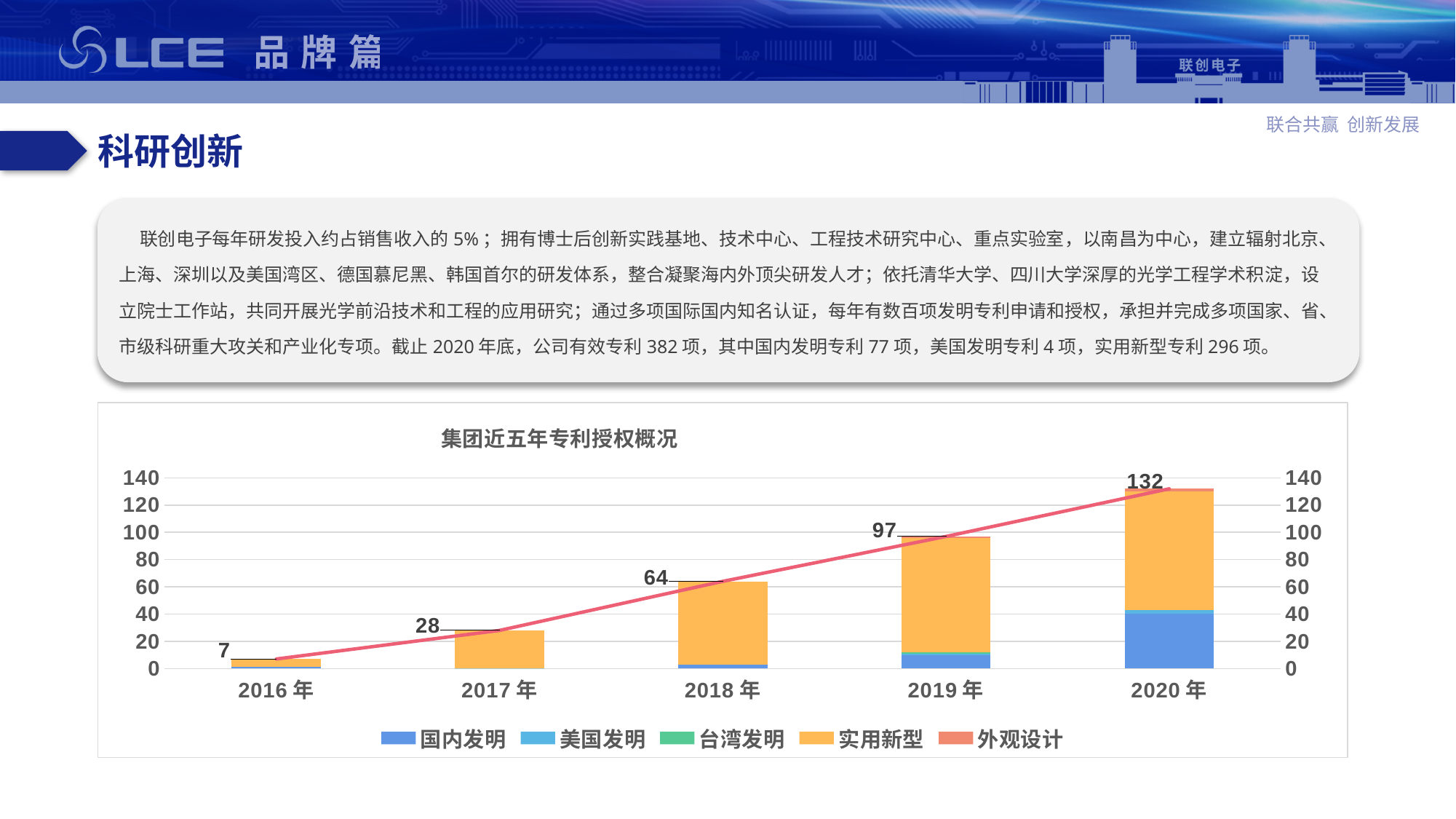
What is the total value shown for 2018 年? 64 Is the 国内发明 value for 2020 年 greater or less than 20? greater What is the total value shown for 2016 年? 7 Which year has the lowest total in the chart? 2016 年 What is the total value shown for 2020 年 in the chart? 132 Which year has the highest total in the chart? 2020 年 How many years are shown on the x axis of the chart? 5 Which is larger, the total for 2017 年 or the total for 2019 年? 2019 年 How many series does the chart legend list? 5 What is the difference between the totals for 2018 年 and 2017 年? 36 Do the totals rise or fall from 2016 年 to 2020 年? rise What is the difference between the totals for 2020 年 and 2019 年? 35